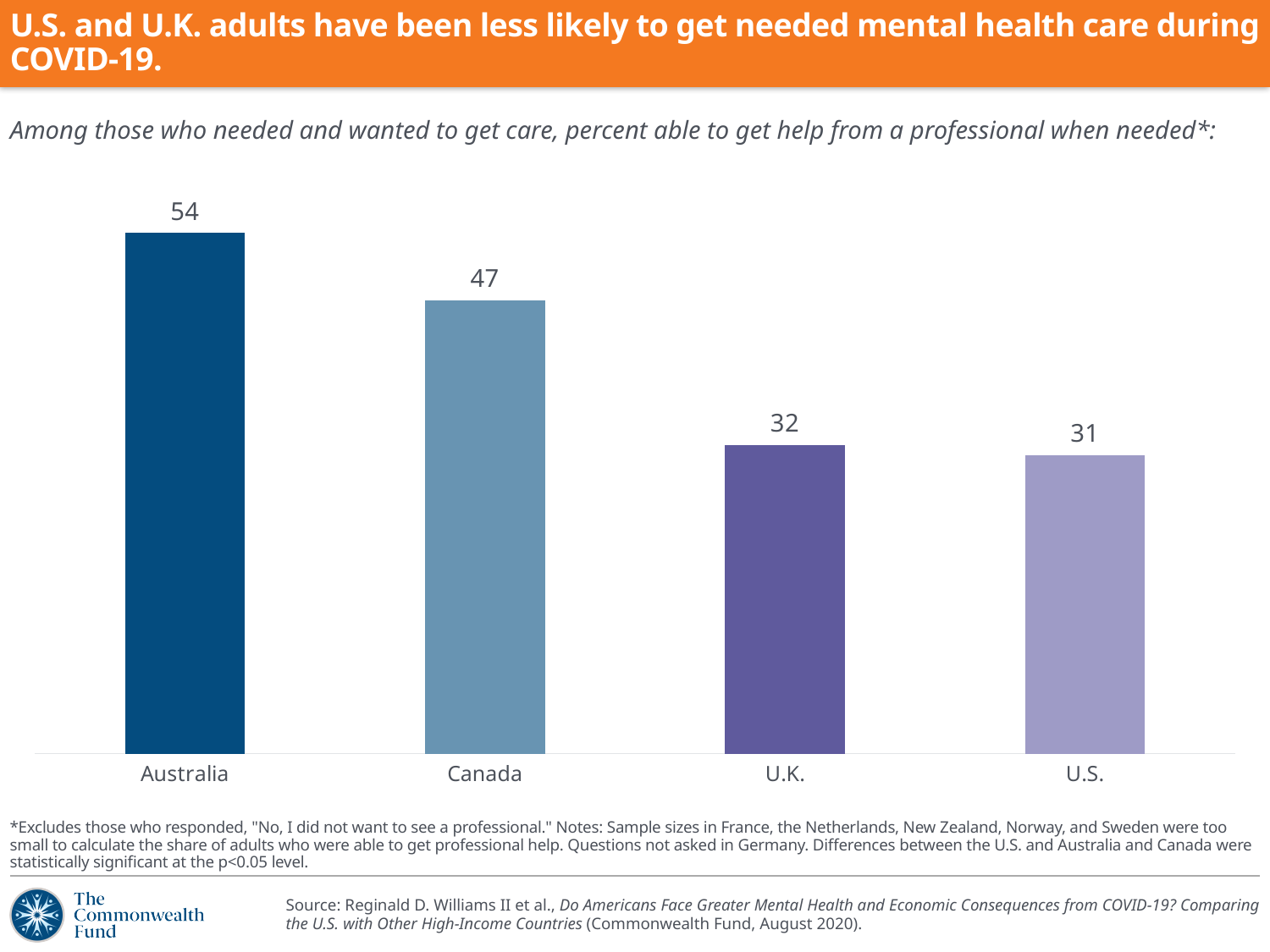
What is the difference between the values for Canada and the U.K.? 15 What is the value for the U.S.? 31 How many countries are shown in the chart? 4 What is the value for the U.K.? 32 What kind of chart is shown on the slide? Bar chart What is the value for Canada? 47 Do the values rise or fall from left to right across the countries? Fall Which country has the highest value? Australia What is the difference between the values for Australia and the U.S.? 23 Which is larger, the value for Canada or the value for the U.K.? Canada Which country has the lowest value? U.S. What is the value for Australia? 54